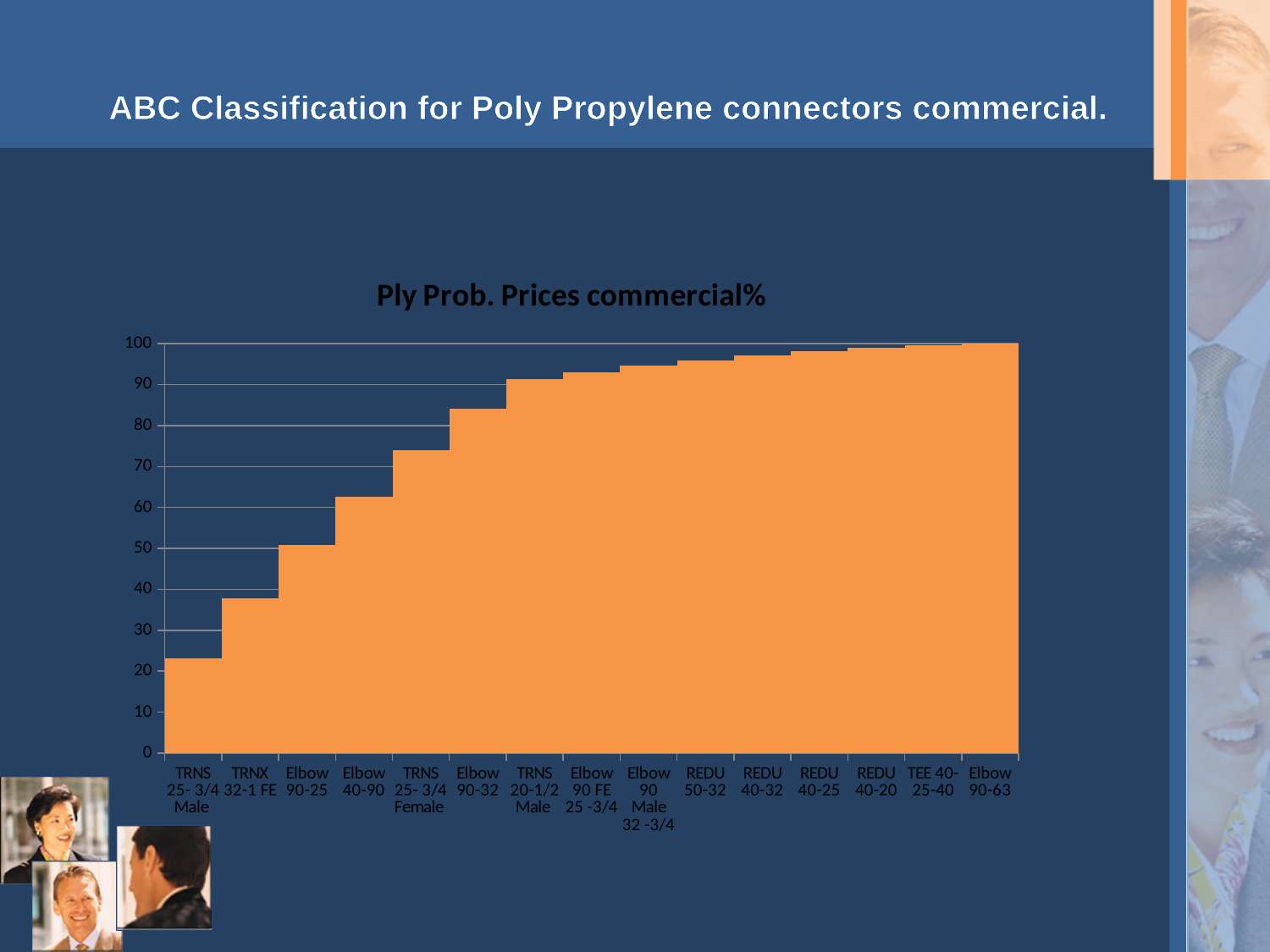
What colour are the bars in the chart? orange Do the values rise or fall from left to right along the x axis? rise Is the value for TRNX 32-1 FE greater or less than 40? less Which is larger, the value for Elbow 90-25 or the value for TRNX 32-1 FE? Elbow 90-25 What is the title of the chart? Ply Prob. Prices commercial% What kind of chart is shown on the slide? bar chart Is the value for Elbow 40-90 greater or less than 60? greater Is the value for Elbow 90-32 greater or less than 80? greater How many categories are plotted along the x axis? 15 Which category has the lowest value? TRNS 25- 3/4 Male